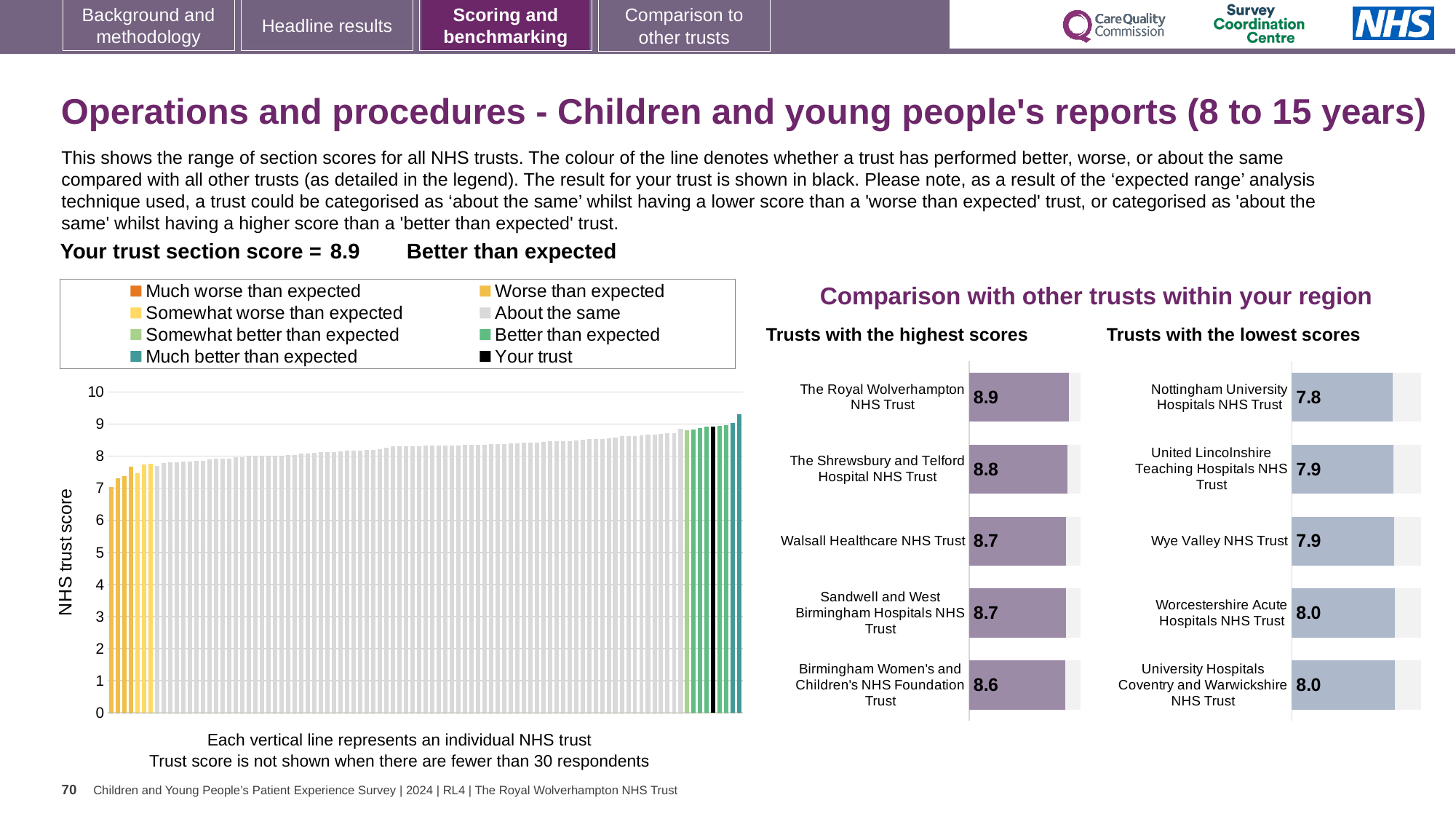
In the 'Trusts with the highest scores' chart, what is the score for Walsall Healthcare NHS Trust? 8.7 In the 'Trusts with the highest scores' chart, what is the difference between the scores of The Royal Wolverhampton NHS Trust and Birmingham Women's and Children's NHS Foundation Trust? 0.3 In the 'Trusts with the highest scores' chart, which trust has the highest score? The Royal Wolverhampton NHS Trust In the main NHS trust score chart on the left, do the bar values rise or fall from left to right? rise What kind of chart is the main chart on the left showing NHS trust scores? bar chart In the 'Trusts with the lowest scores' chart, what is the score for Worcestershire Acute Hospitals NHS Trust? 8.0 In the 'Trusts with the lowest scores' chart, which trust has the lowest score? Nottingham University Hospitals NHS Trust In the main NHS trust score chart on the left, is the value of the black 'Your trust' bar greater or less than 8? greater How many entries does the legend of the main NHS trust score chart on the left list? 8 How many trusts are listed in the 'Trusts with the highest scores' chart? 5 In the 'Trusts with the highest scores' chart, which has the higher score: The Shrewsbury and Telford Hospital NHS Trust or Walsall Healthcare NHS Trust? The Shrewsbury and Telford Hospital NHS Trust In the 'Trusts with the lowest scores' chart, what is the score for Nottingham University Hospitals NHS Trust? 7.8